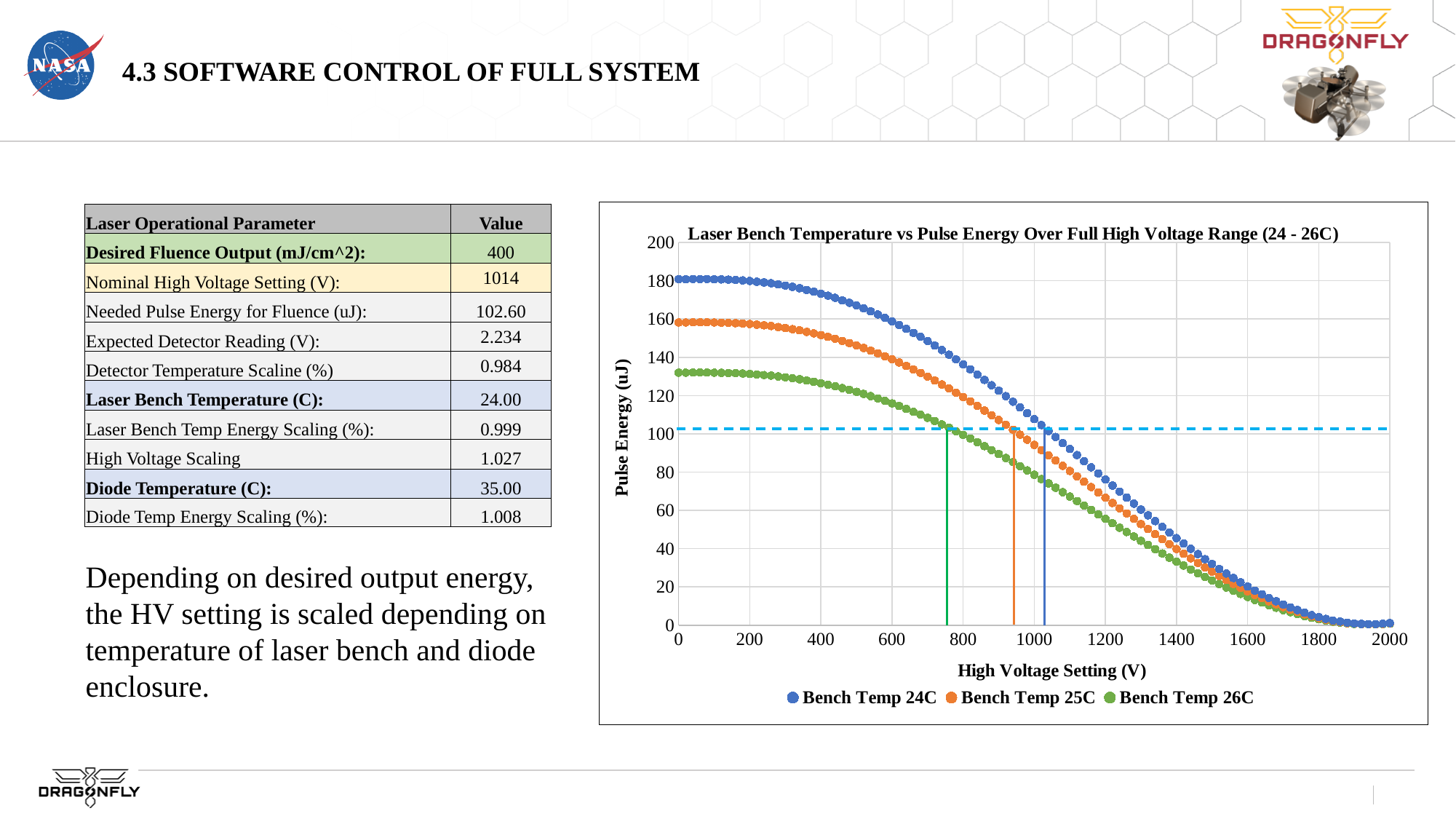
At a high voltage setting of 400 V, which series has the larger pulse energy, Bench Temp 24C or Bench Temp 26C? Bench Temp 24C What kind of chart is shown on the slide? scatter chart Is the pulse energy for Bench Temp 26C at 1200 V greater or less than 80? less Which series has the lowest pulse energy at a high voltage setting of 0 V? Bench Temp 26C What is the label of the chart's y axis? Pulse Energy (uJ) Which series has the highest pulse energy at a high voltage setting of 0 V? Bench Temp 24C Is the pulse energy for Bench Temp 24C at 0 V greater or less than 160? greater Is the pulse energy for Bench Temp 26C at 0 V greater or less than 140? less What is the title of the chart? Laser Bench Temperature vs Pulse Energy Over Full High Voltage Range (24 - 26C) Do the pulse energy values rise or fall as the high voltage setting increases? fall How many series does the chart legend list? 3